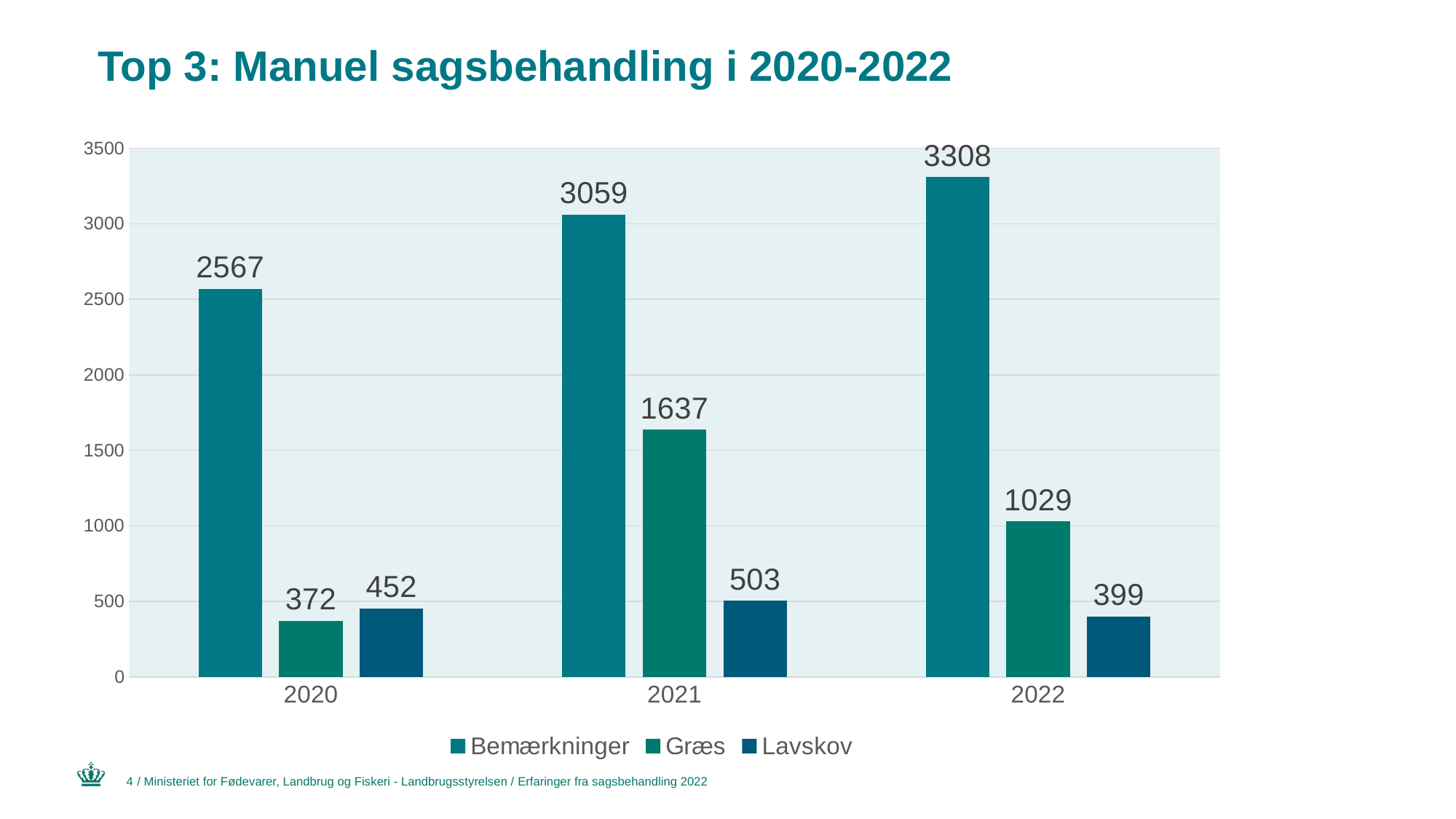
What is the value for Bemærkninger in 2021? 3059 What kind of chart is shown on the slide? bar chart What is the value for Græs in 2022? 1029 What is the difference between the Bemærkninger values for 2022 and 2020? 741 In which year is the Bemærkninger value highest? 2022 Which is larger in 2021: Græs or Lavskov? Græs How many series does the legend list? 3 Is the value for Lavskov in 2022 greater or less than 500? less Does the Bemærkninger series rise or fall from 2020 to 2022? rise What is the value for Lavskov in 2020? 452 How many years are shown on the x axis? 3 In which year is the Græs value lowest? 2020